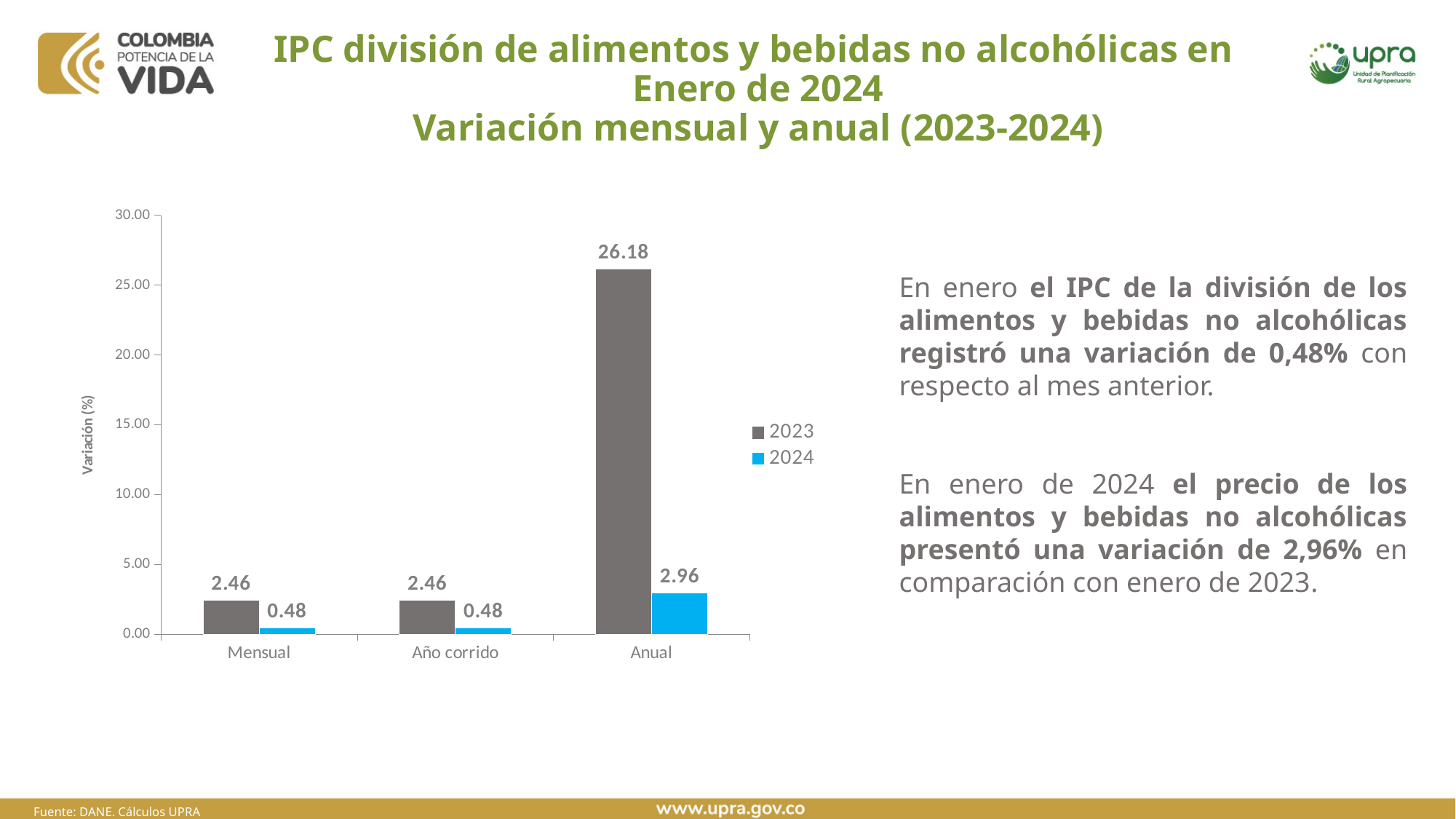
Which category has the highest value for the 2024 series? Anual What is the value for 2023 in the Año corrido category? 2.46 What kind of chart is shown on the slide? Bar chart How many series does the legend list? 2 What is the difference between the 2023 and 2024 values in the Mensual category? 1.98 What is the value for 2023 in the Anual category? 26.18 What is the value for 2024 in the Mensual category? 0.48 How many categories are shown on the x axis? 3 In the Anual category, which series has the larger value, 2023 or 2024? 2023 What is the difference between the 2023 and 2024 values in the Anual category? 23.22 What is the value for 2024 in the Anual category? 2.96 Which category has the highest value for the 2023 series? Anual